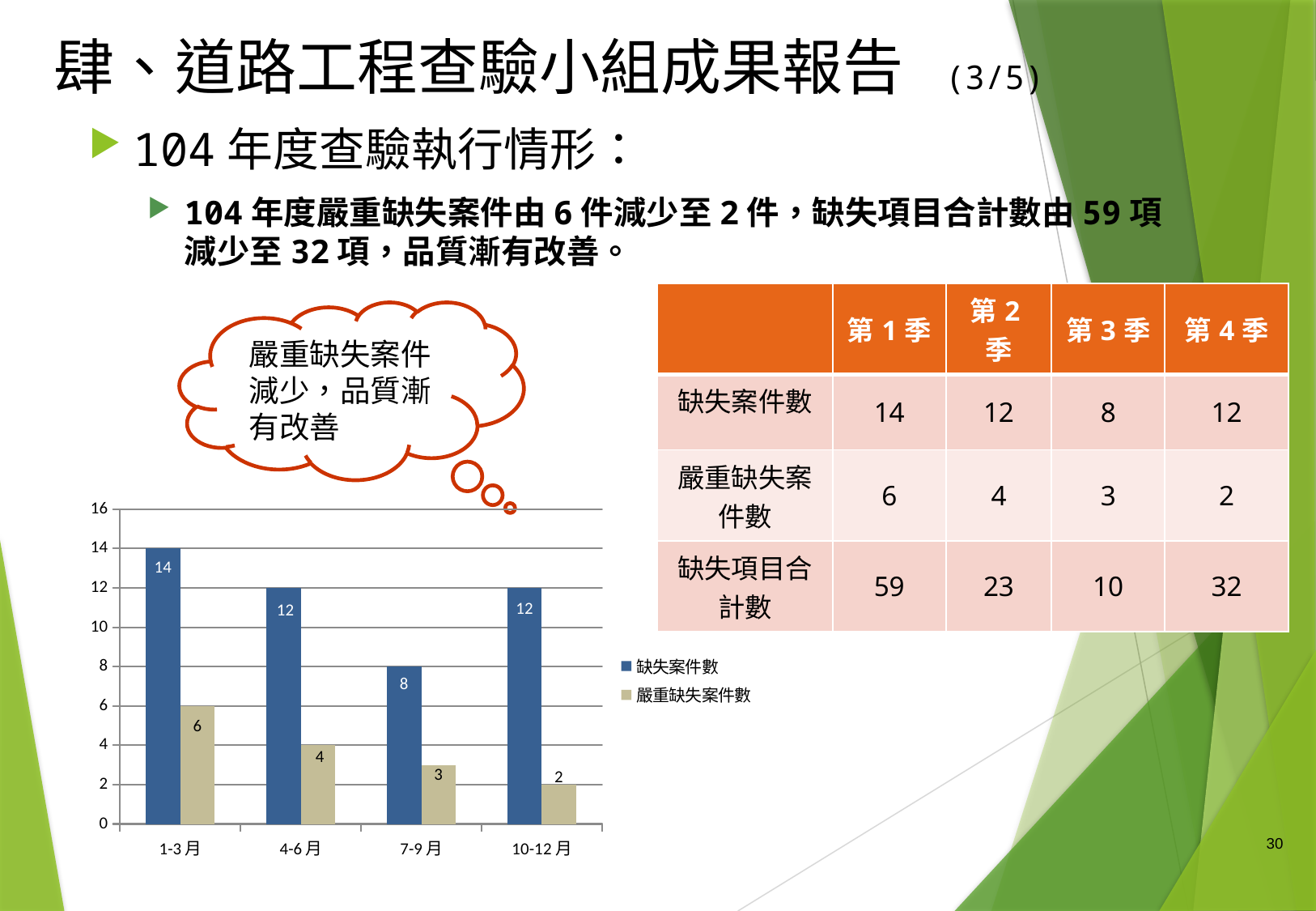
How many periods are shown on the x axis of the chart? 4 What is the value of 嚴重缺失案件數 for 10-12月? 2 How many series does the chart legend list? 2 Which period has the highest value for 缺失案件數? 1-3月 What is the difference between 缺失案件數 and 嚴重缺失案件數 for 4-6月? 8 What is the value of 缺失案件數 for 7-9月? 8 What kind of chart is shown on the slide? bar chart What is the value of 缺失案件數 for 1-3月? 14 Do the values for 嚴重缺失案件數 rise or fall from 1-3月 to 10-12月? fall Which is larger, 缺失案件數 for 7-9月 or 缺失案件數 for 10-12月? 10-12月 Which period has the lowest value for 嚴重缺失案件數? 10-12月 Is the value of 缺失案件數 for 1-3月 greater or less than 10? greater